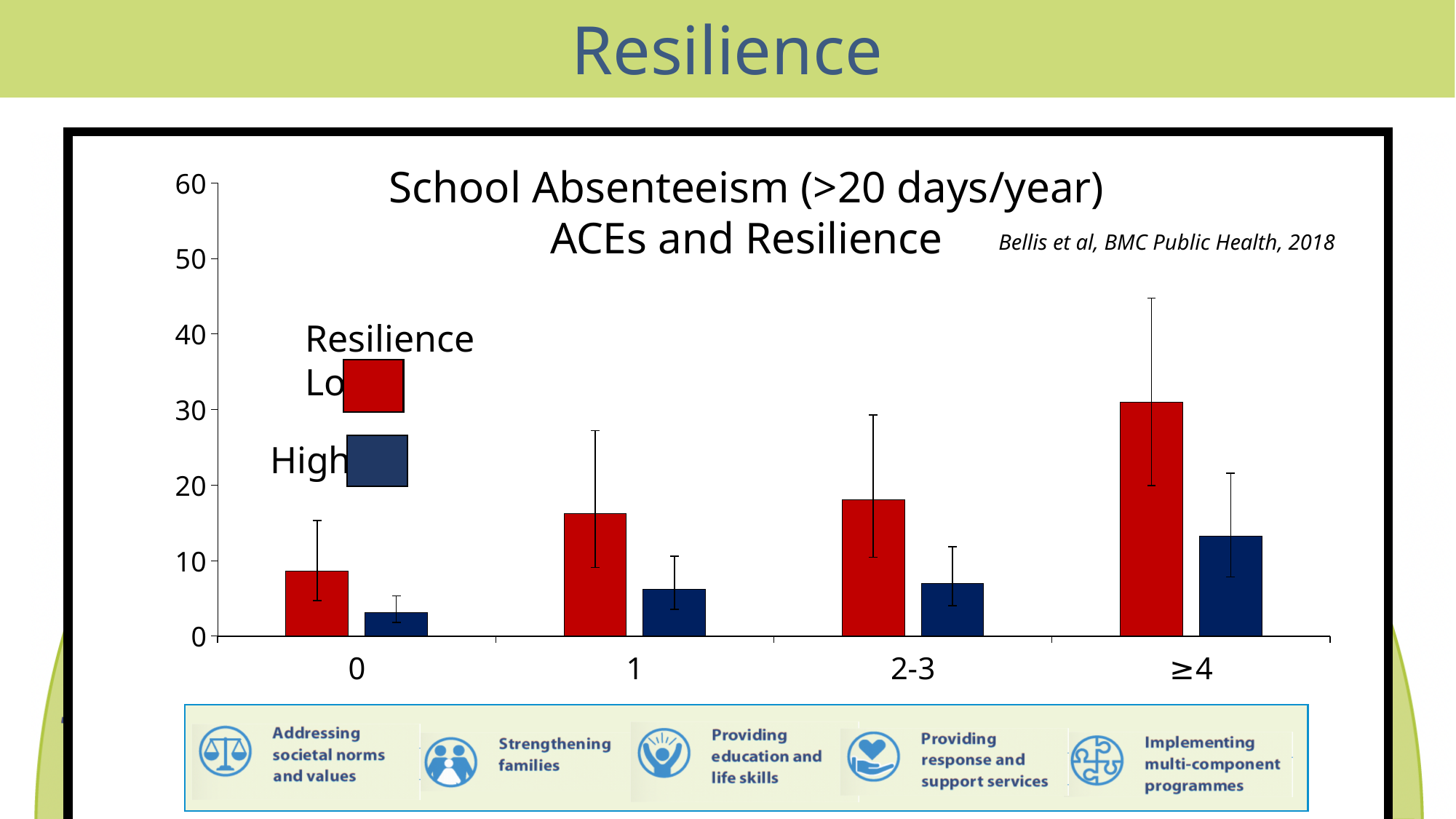
How many series does the legend list? 2 Is the Low resilience value for 0 ACEs greater or less than 10? less Do the Low resilience values rise or fall as the number of ACEs increases along the x axis? rise Is the High resilience value for ≥4 ACEs greater or less than 10? greater How many ACE categories are shown on the x axis? 4 For the ≥4 ACEs category, which is larger: Low resilience or High resilience? Low resilience Which ACE category has the highest value for Low resilience? ≥4 Which ACE category has the highest value for High resilience? ≥4 Which ACE category has the lowest value for High resilience? 0 What kind of chart is shown on the slide? bar chart Is the Low resilience value for ≥4 ACEs greater or less than 20? greater Which colour represents Low resilience in the legend? red